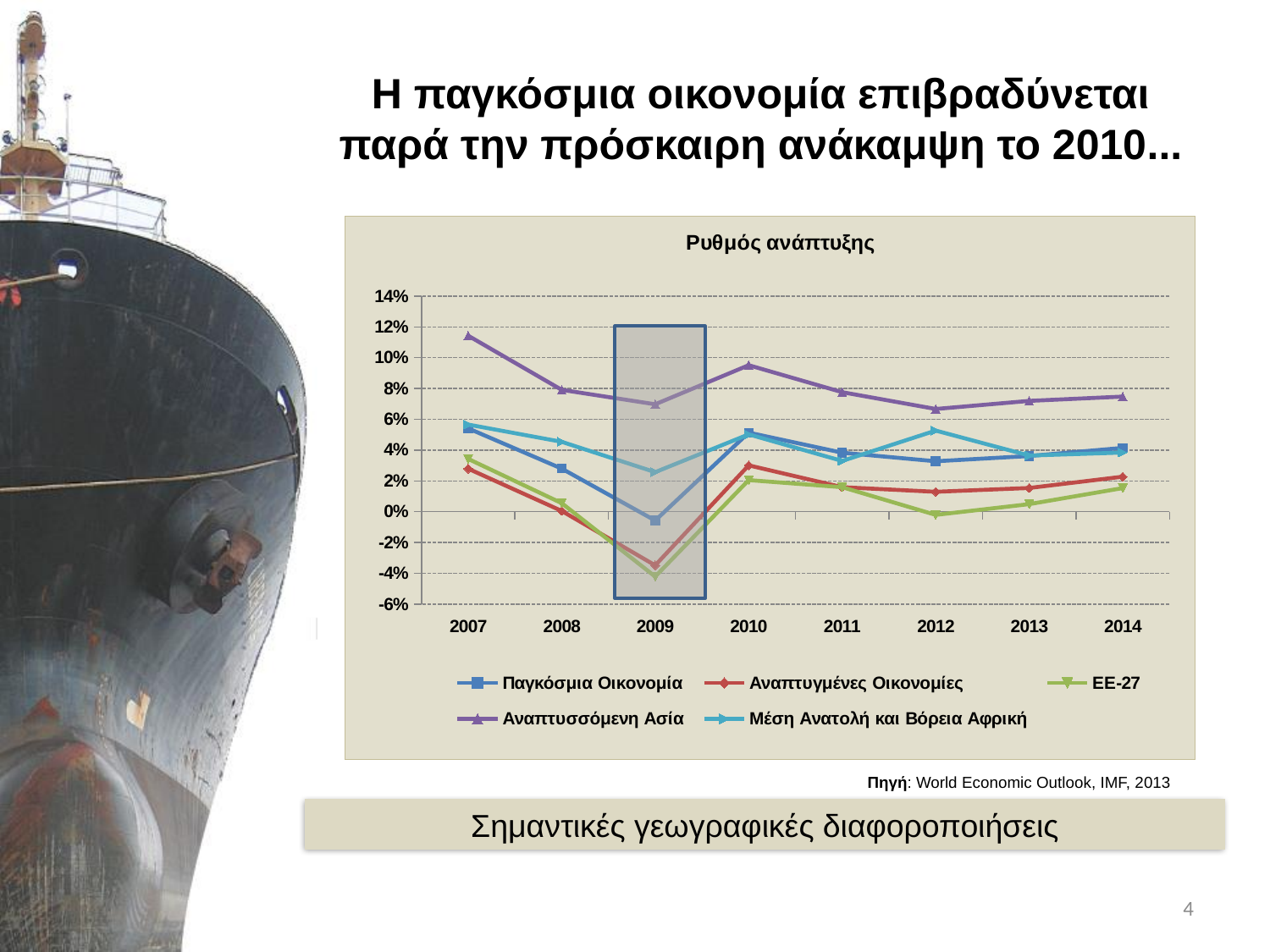
How many series does the legend of the chart list? 5 What is the title of the chart? Ρυθμός ανάπτυξης Which series has the highest value in 2009? Αναπτυσσόμενη Ασία Is the value for Παγκόσμια Οικονομία in 2010 greater or less than 4%? greater Is the value for ΕΕ-27 in 2009 greater or less than -2%? less Which series has the highest value in 2007? Αναπτυσσόμενη Ασία What kind of chart is shown on the slide? line chart Does the value for Αναπτυσσόμενη Ασία rise or fall from 2007 to 2009? fall Is the value for Αναπτυσσόμενη Ασία in 2007 greater or less than 10%? greater In 2010, which is larger: the value for Αναπτυσσόμενη Ασία or the value for Μέση Ανατολή και Βόρεια Αφρική? Αναπτυσσόμενη Ασία How many years are shown on the x axis of the chart? 8